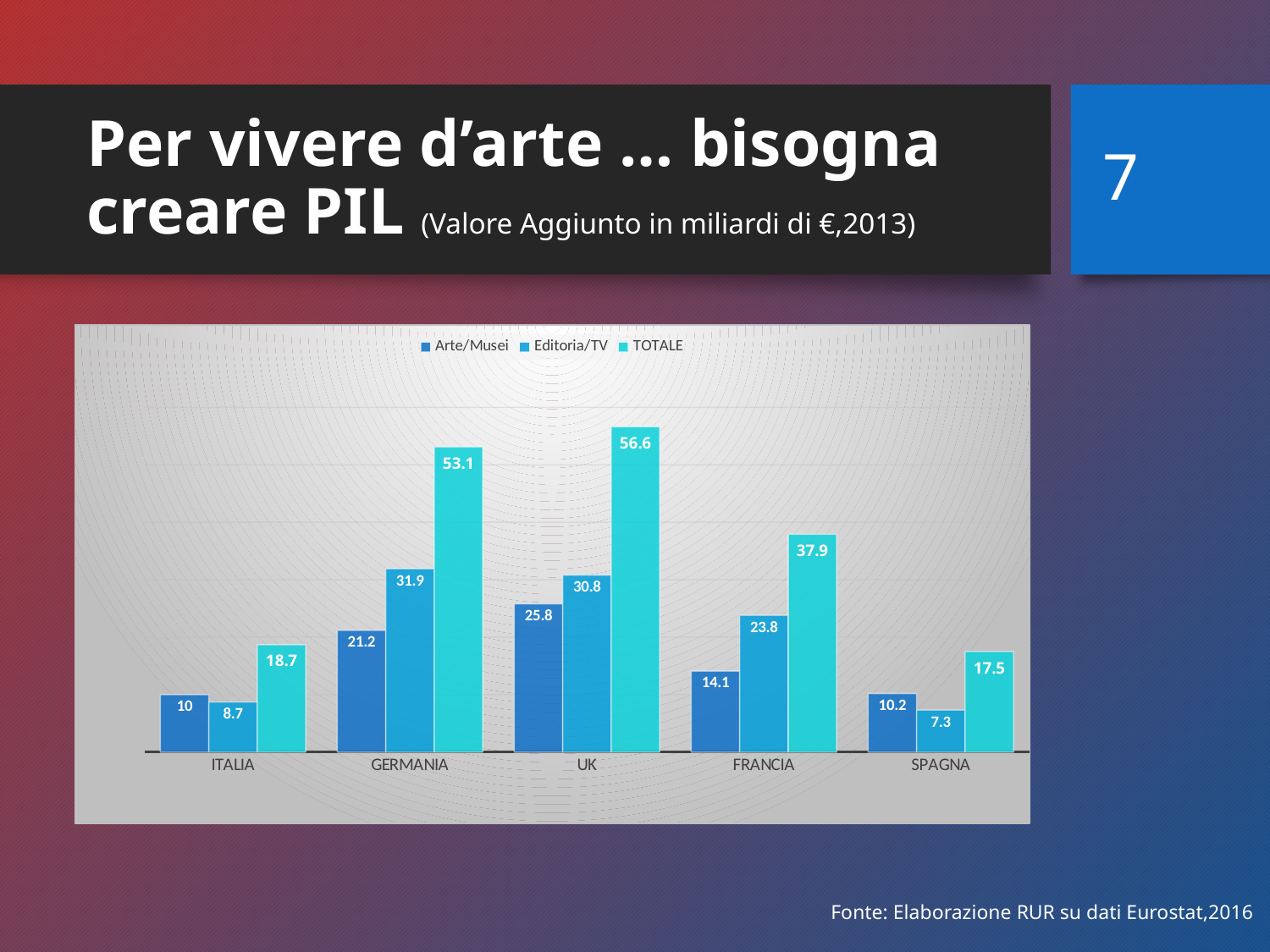
What are the three series listed in the legend? Arte/Musei, Editoria/TV, TOTALE What is the Arte/Musei value for GERMANIA? 21.2 Which country has the lowest Editoria/TV value? SPAGNA Which country has the highest TOTALE value? UK Which is larger, the Arte/Musei value for ITALIA or for SPAGNA? SPAGNA What is the difference between the Editoria/TV and Arte/Musei values for UK? 5 How many countries are shown on the x axis? 5 How many series does the legend list? 3 What is the difference between the TOTALE values for UK and GERMANIA? 3.5 What kind of chart is shown on the slide? Bar chart What is the TOTALE value for SPAGNA? 17.5 What is the Editoria/TV value for FRANCIA? 23.8